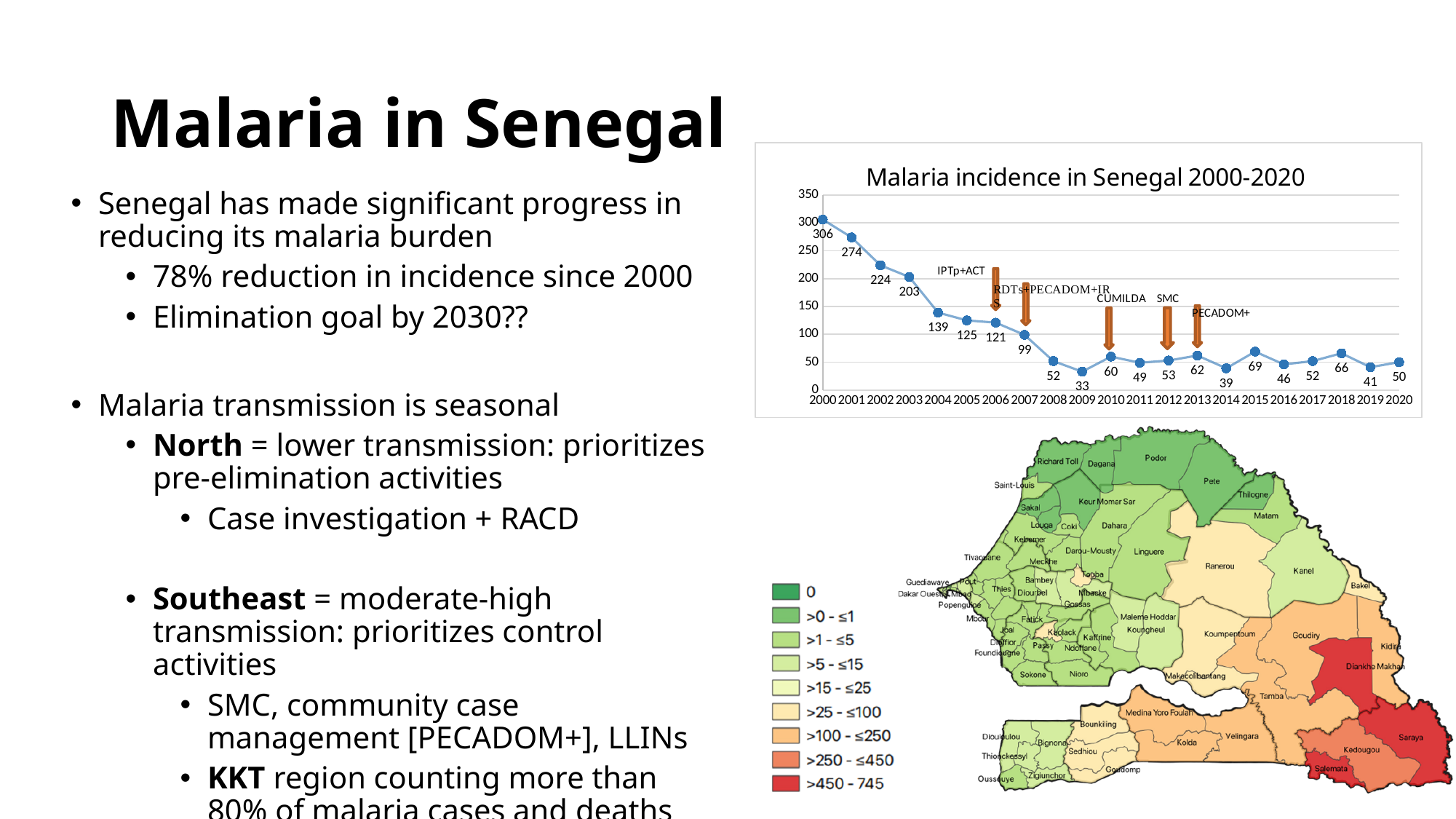
In the 'Malaria incidence in Senegal 2000-2020' chart, is the value for 2003 greater or less than 150? greater In the 'Malaria incidence in Senegal 2000-2020' chart, what is the difference between the 2004 value and the 2007 value? 40 What kind of chart is 'Malaria incidence in Senegal 2000-2020'? line chart What is the malaria incidence value for 2020 in the 'Malaria incidence in Senegal 2000-2020' chart? 50 How many years (data points) are plotted in the 'Malaria incidence in Senegal 2000-2020' chart? 21 What is the malaria incidence value for 2009 in the 'Malaria incidence in Senegal 2000-2020' chart? 33 What is the malaria incidence value for 2000 in the 'Malaria incidence in Senegal 2000-2020' chart? 306 Which year has the lowest malaria incidence in the 'Malaria incidence in Senegal 2000-2020' chart? 2009 In the 'Malaria incidence in Senegal 2000-2020' chart, which year has the larger value, 2015 or 2018? 2015 Which year has the highest malaria incidence in the 'Malaria incidence in Senegal 2000-2020' chart? 2000 Does malaria incidence generally rise or fall from 2000 to 2020 in the 'Malaria incidence in Senegal 2000-2020' chart? fall In the 'Malaria incidence in Senegal 2000-2020' chart, what is the difference between the 2000 value and the 2020 value? 256